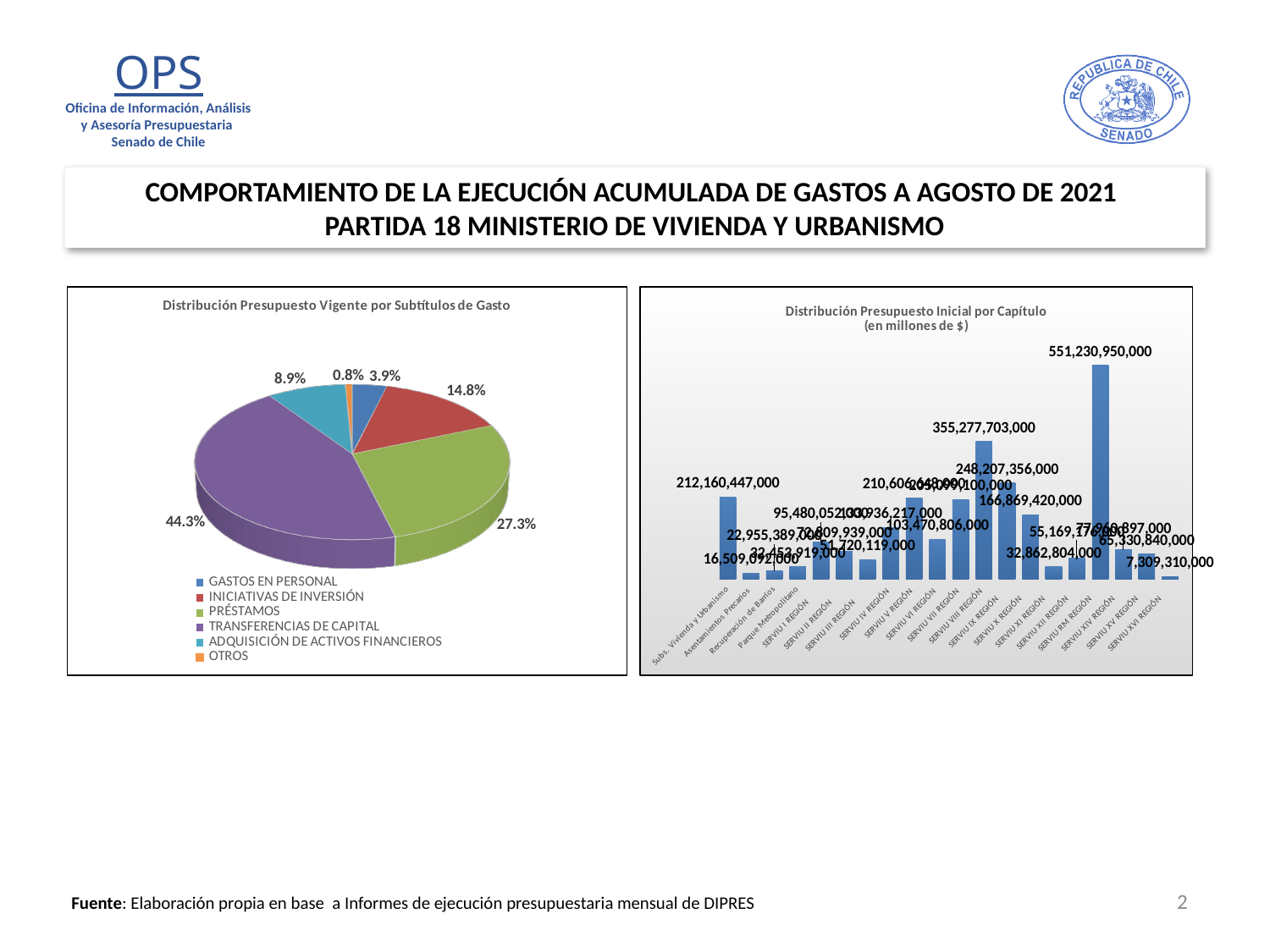
In the pie chart 'Distribución Presupuesto Vigente por Subtítulos de Gasto', what share does TRANSFERENCIAS DE CAPITAL have? 44.3% In the pie chart 'Distribución Presupuesto Vigente por Subtítulos de Gasto', what is the difference in percentage points between TRANSFERENCIAS DE CAPITAL and PRÉSTAMOS? 17.0 percentage points In the bar chart 'Distribución Presupuesto Inicial por Capítulo', what is the value for SERVIU VIII REGIÓN? 355,277,703,000 In the pie chart 'Distribución Presupuesto Vigente por Subtítulos de Gasto', how many categories does the legend list? 6 In the pie chart 'Distribución Presupuesto Vigente por Subtítulos de Gasto', what share does PRÉSTAMOS have? 27.3% In the bar chart 'Distribución Presupuesto Inicial por Capítulo', which chapter has the highest value? SERVIU RM REGIÓN What kind of chart is the left chart, 'Distribución Presupuesto Vigente por Subtítulos de Gasto'? Pie chart In the bar chart 'Distribución Presupuesto Inicial por Capítulo', which chapter has the lowest value? SERVIU XVI REGIÓN In the pie chart 'Distribución Presupuesto Vigente por Subtítulos de Gasto', which category has the smallest share? OTROS What kind of chart is the right chart, 'Distribución Presupuesto Inicial por Capítulo'? Bar chart In the bar chart 'Distribución Presupuesto Inicial por Capítulo', how many chapters (bars) are shown? 20 In the bar chart 'Distribución Presupuesto Inicial por Capítulo', what is the value for SERVIU RM REGIÓN? 551,230,950,000